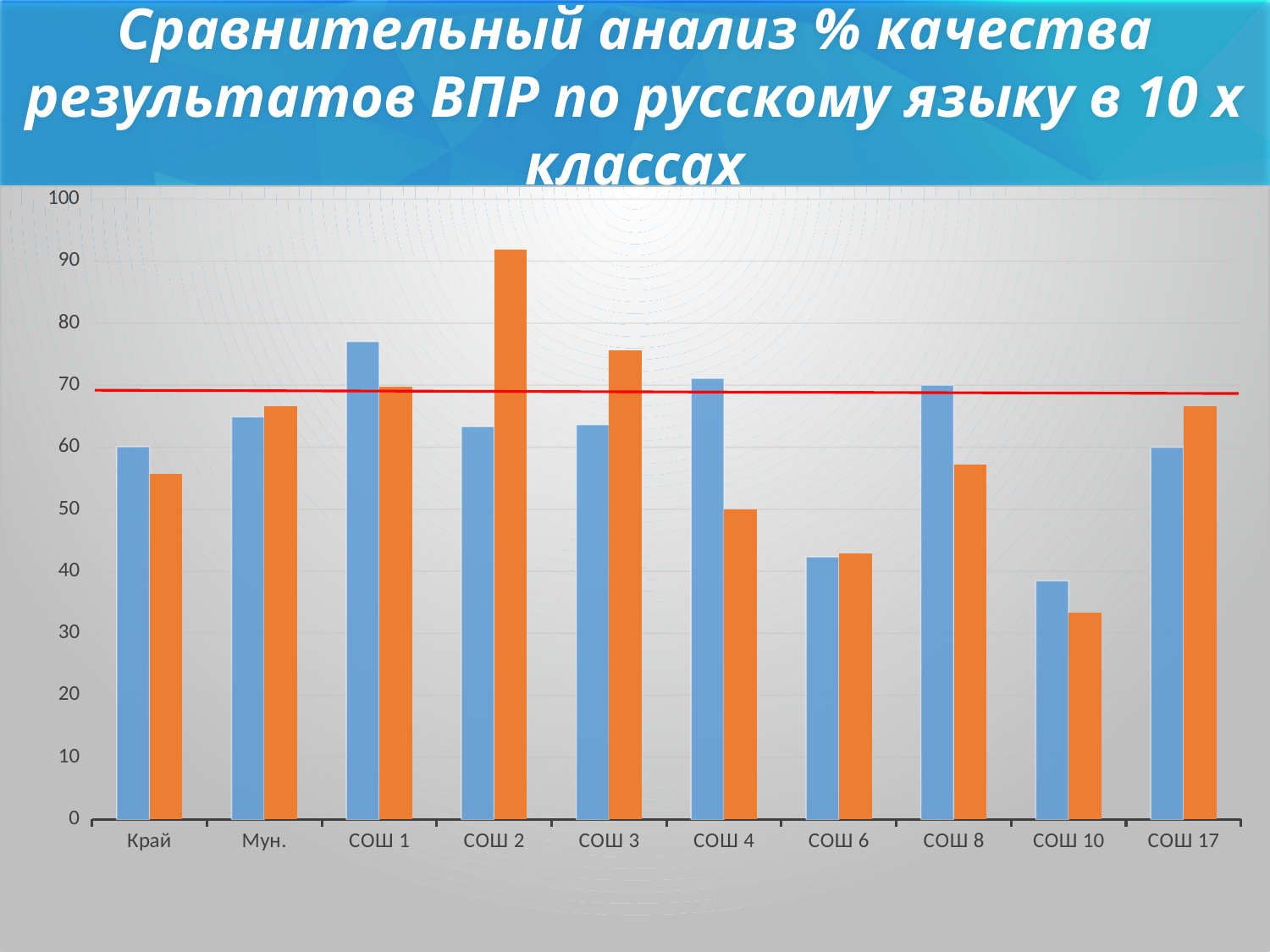
What kind of chart is shown on the slide? bar chart Which category has the tallest orange bar? СОШ 2 Which category has the tallest blue bar? СОШ 1 Is the orange bar for СОШ 3 greater or less than 70? greater Is the orange bar for СОШ 2 greater or less than 80? greater For СОШ 4, which bar is taller, the blue one or the orange one? the blue one Is the blue bar for СОШ 6 greater or less than 50? less What colour is the horizontal line drawn across the chart near the 70 mark? red For СОШ 2, which bar is taller, the blue one or the orange one? the orange one Which category has the shortest blue bar? СОШ 10 How many categories are shown along the x axis of the chart? 10 Which category has the shortest orange bar? СОШ 10